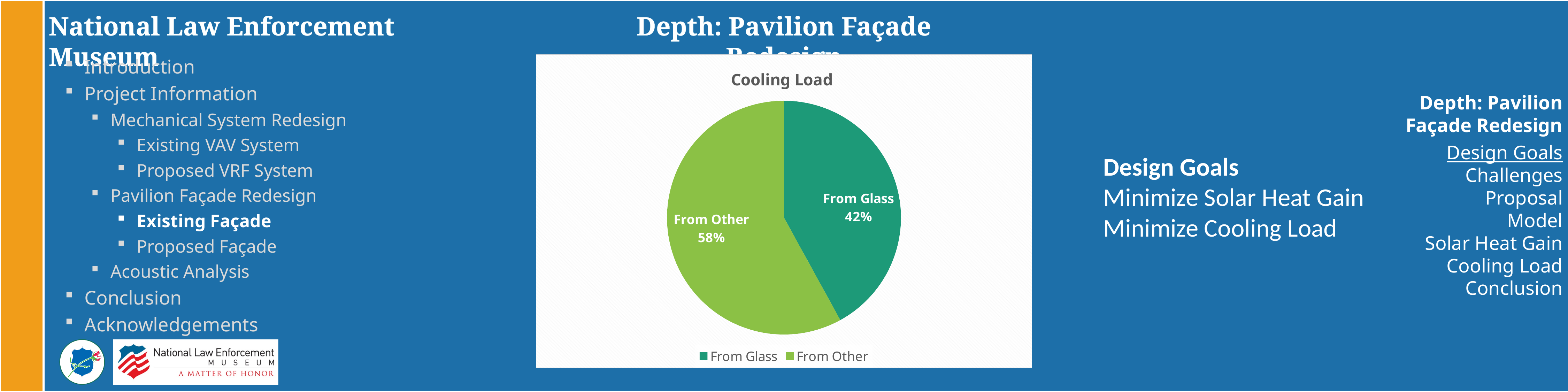
Which slice of the pie is the largest? From Other How many entries does the legend list? 2 How many slices does the pie chart have? 2 What kind of chart is shown on the slide? pie chart What is the title of the chart? Cooling Load Which slice of the pie is the smallest? From Glass Is the share for From Glass greater or less than 50%? less What is the difference in percentage points between the From Other and From Glass slices? 16 What share of the cooling load comes from other sources? 58% What share of the cooling load comes from glass? 42% Which is larger, the From Glass slice or the From Other slice? From Other Which legend entry is shown in light green? From Other